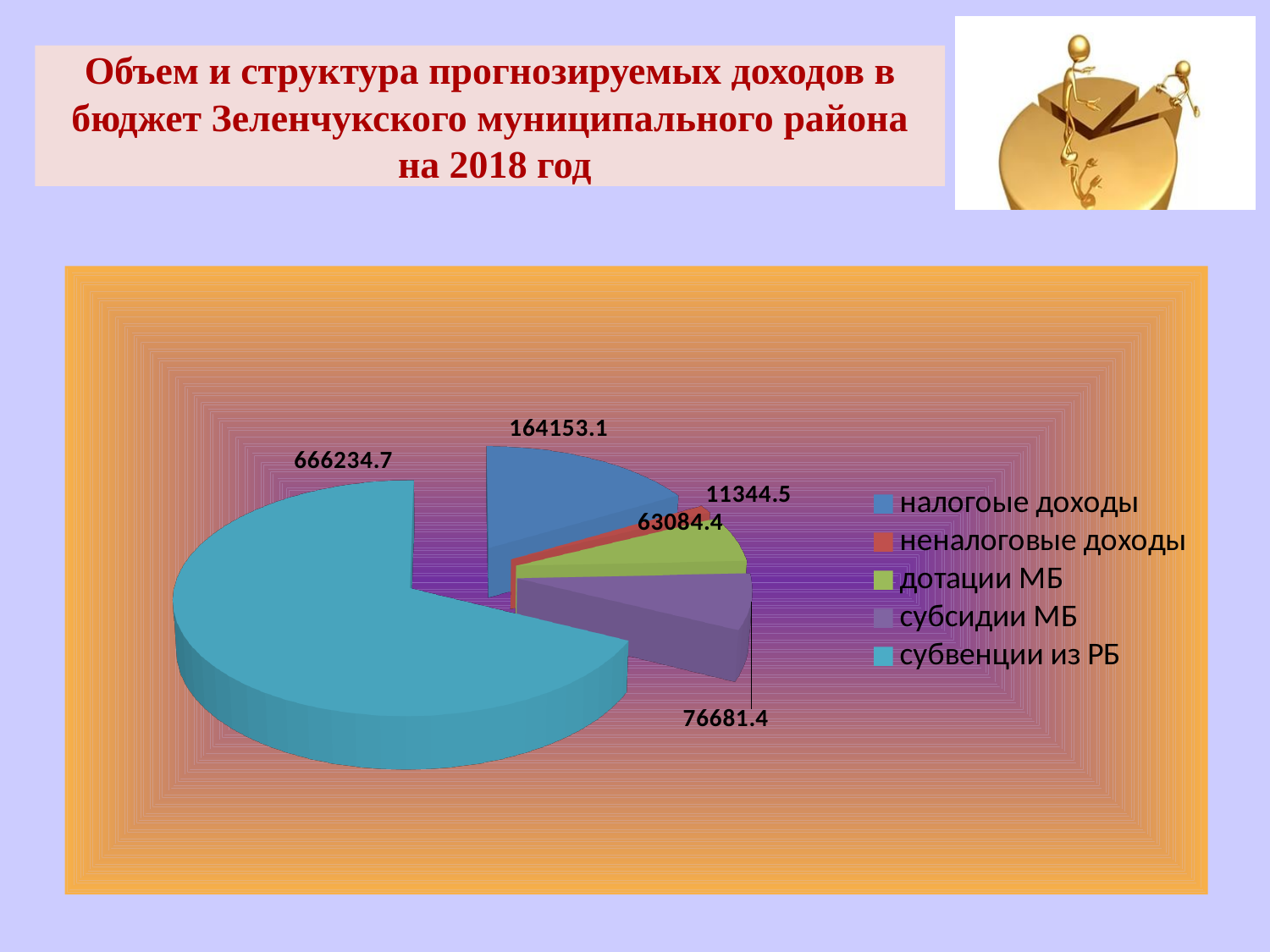
Which category has the largest value? субвенции из РБ What is the difference between налогоые доходы and неналоговые доходы? 152808.6 What type of chart is shown on the slide? pie chart How many categories does the pie chart have? 5 Which category has the smallest value? неналоговые доходы What is the value for налогоые доходы? 164153.1 What is the value for субвенции из РБ? 666234.7 What is the value for дотации МБ? 63084.4 What is the value for неналоговые доходы? 11344.5 What is the value for субсидии МБ? 76681.4 Which is larger, субсидии МБ or дотации МБ? субсидии МБ What colour is the slice for субвенции из РБ? cyan (light blue)